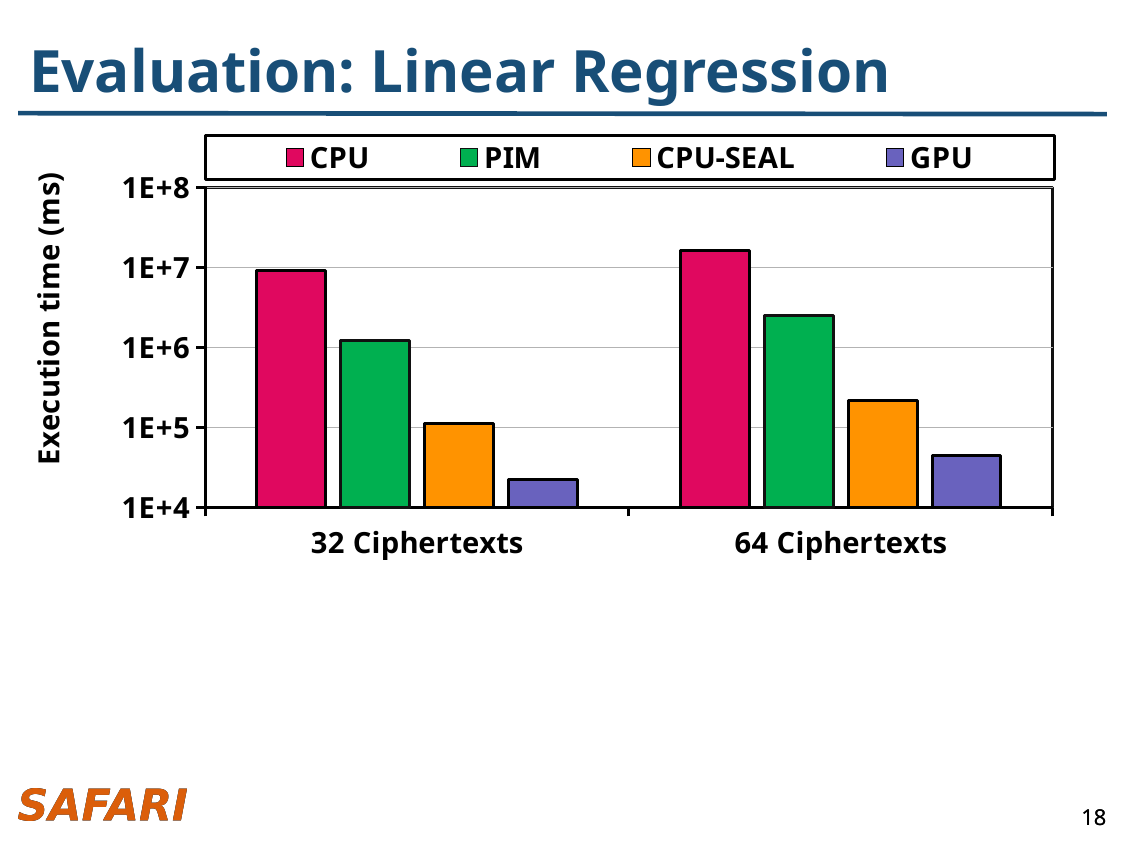
Which series has the highest execution time for 64 Ciphertexts? CPU Which series has the lowest execution time for 32 Ciphertexts? GPU How many series does the legend list? 4 What is the label of the y axis? Execution time (ms) Is the execution time for PIM at 64 Ciphertexts greater or less than 1E+6? greater Is the execution time for CPU at 64 Ciphertexts greater or less than 1E+7? greater What kind of chart is shown on the slide? bar chart How many categories are shown on the x axis? 2 Does the execution time for GPU rise or fall from 32 Ciphertexts to 64 Ciphertexts? rise For 32 Ciphertexts, which has the larger execution time, PIM or CPU-SEAL? PIM Is the execution time for GPU at 32 Ciphertexts greater or less than 1E+5? less Which bar is the tallest in the whole chart? CPU at 64 Ciphertexts